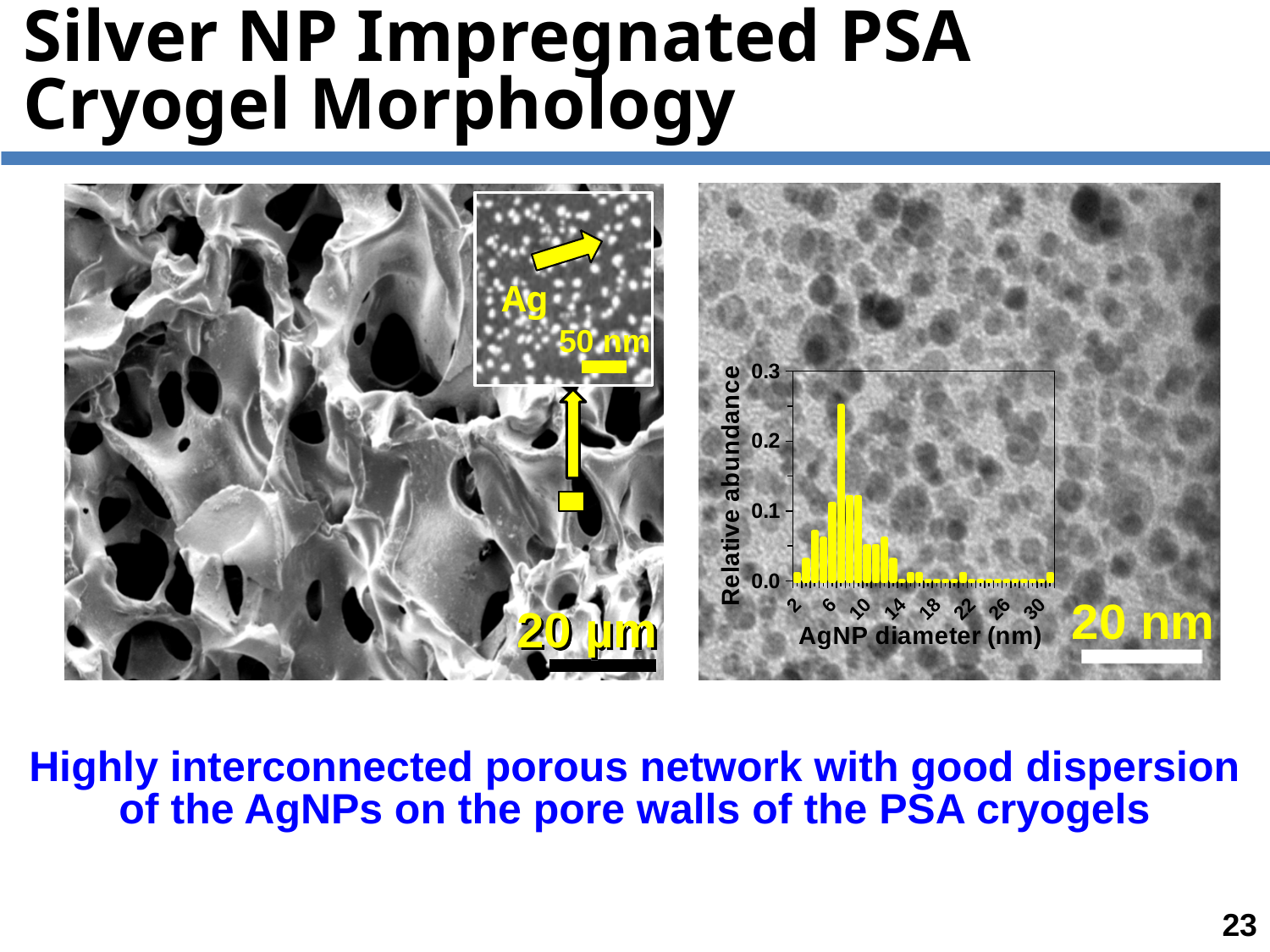
In the inset chart, is the relative abundance higher at 6 nm or at 26 nm? 6 nm In the inset chart, is the relative abundance higher at 22 nm or at 10 nm? 10 nm In the inset chart, is the relative abundance at 2 nm greater or less than 0.1? less In the inset chart, is the relative abundance at 30 nm greater or less than 0.1? less What is the x-axis title of the inset chart? AgNP diameter (nm) What kind of chart is the inset on the right-hand TEM image? bar chart In the inset chart, is the value of the tallest bar greater or less than 0.3? less In the inset chart, do the relative abundance values generally rise or fall as the diameter increases from 10 nm to 30 nm? fall What is the y-axis title of the inset chart? Relative abundance